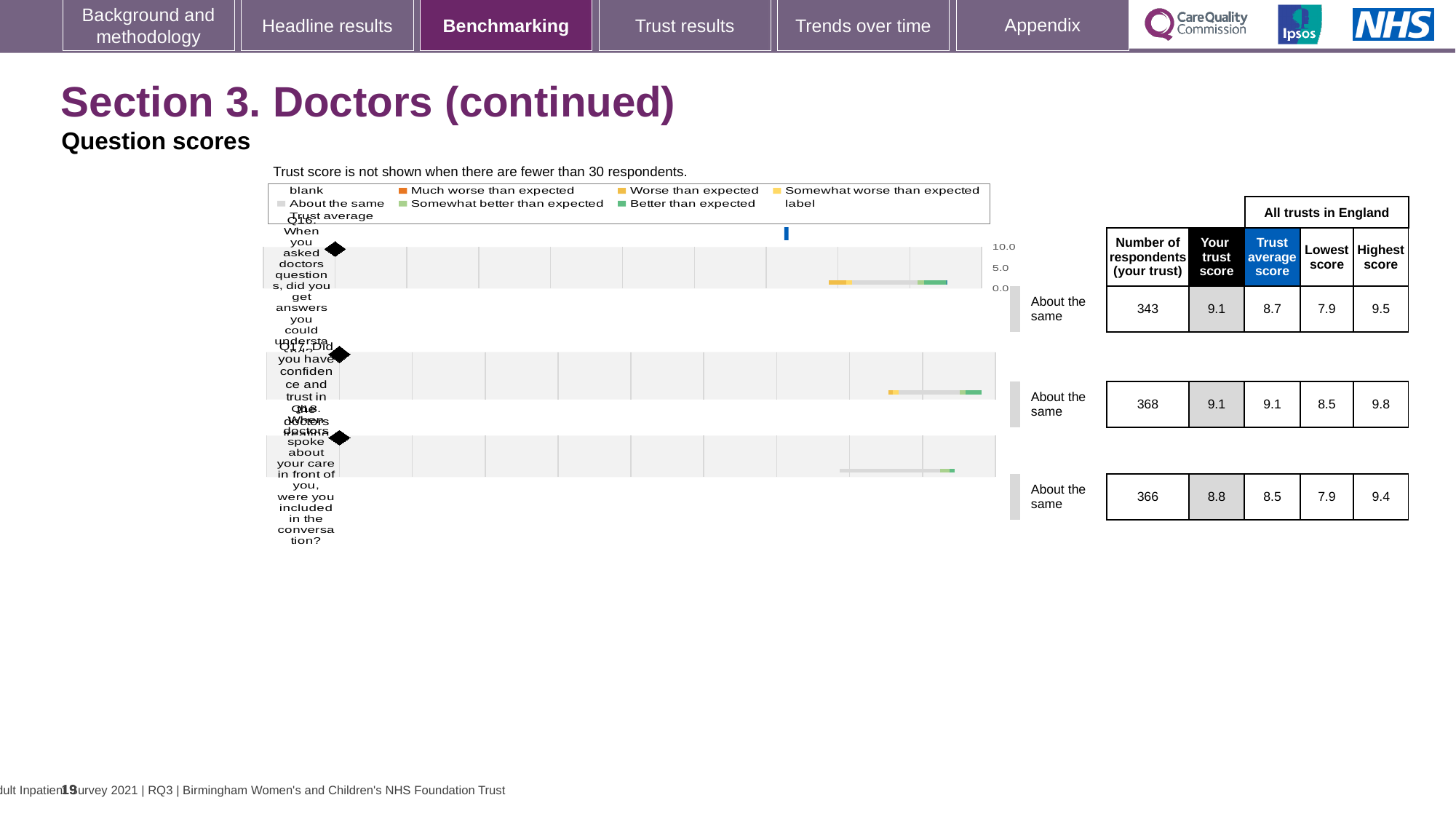
Which question has the highest 'Highest score' value? Q17 How many survey questions are plotted in the benchmarking chart? 3 What is the difference between the 'Your trust score' and the 'Trust average score' for Q18? 0.3 What is the 'Your trust score' for Q16 (When you asked doctors questions, did you get answers you could understand)? 9.1 How many respondents from your trust answered Q18? 366 What is the 'Highest score' across all trusts in England for Q17? 9.8 What is the maximum value shown on the chart's score axis? 10.0 What is the 'Lowest score' across all trusts in England for Q16? 7.9 For Q16, which is larger: the 'Your trust score' or the 'Trust average score'? Your trust score Which question has the lowest 'Your trust score'? Q18 What kind of chart is used to show the question scores? bar chart What benchmark category is shown for Q18? About the same